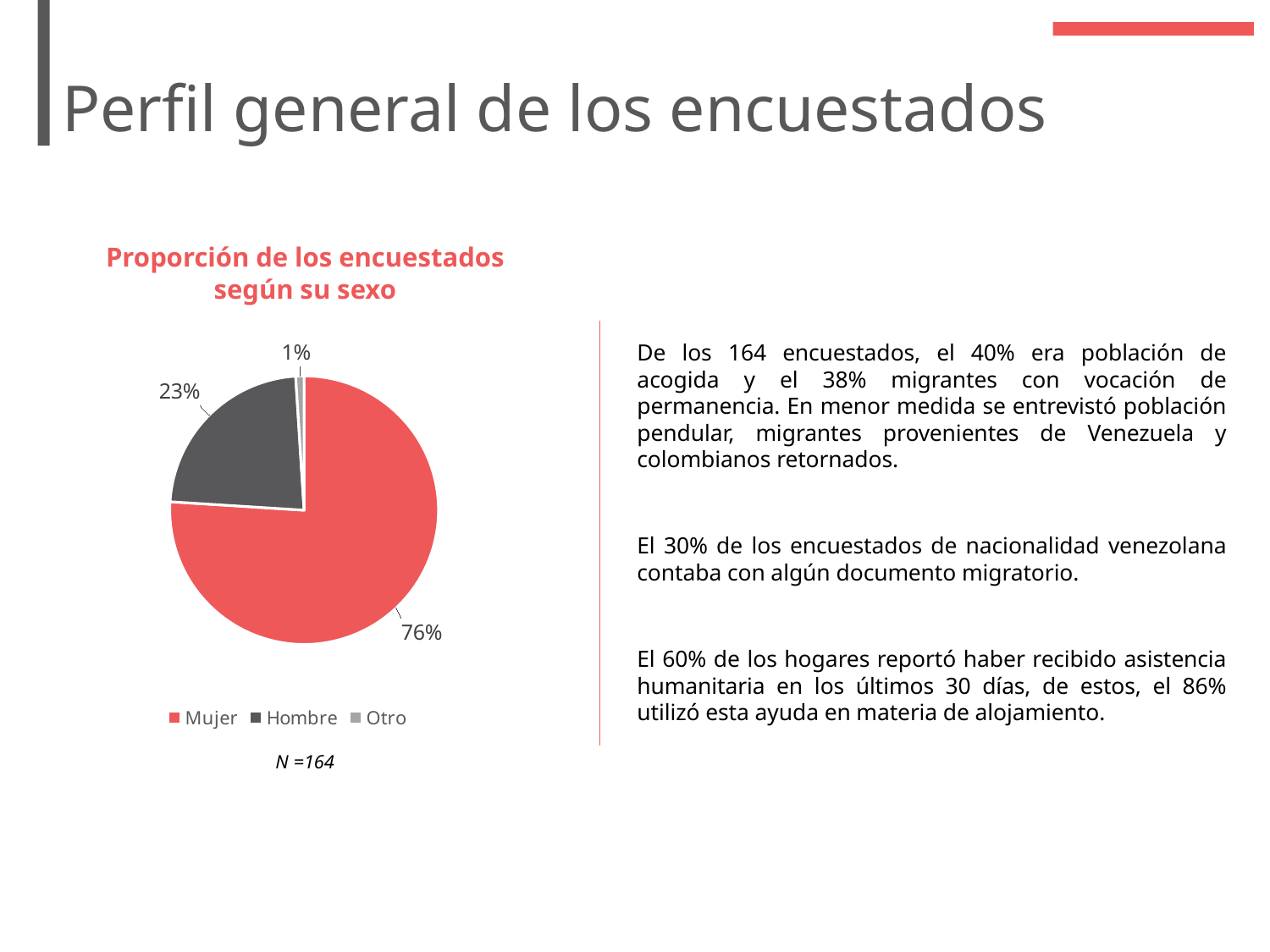
What share of the pie does Otro represent? 1% What share of the pie does Mujer represent? 76% What is the title of the chart? Proporción de los encuestados según su sexo What is the sample size (N) noted below the chart? 164 What share of the pie does Hombre represent? 23% What colour is the Mujer slice in the pie chart? Red Which is larger, the Hombre slice or the Otro slice? Hombre Which category has the smallest slice of the pie? Otro What kind of chart is shown on the slide? Pie chart How many categories does the pie chart show? 3 Which category has the largest slice of the pie? Mujer What is the difference in percentage points between the Mujer and Hombre slices? 53